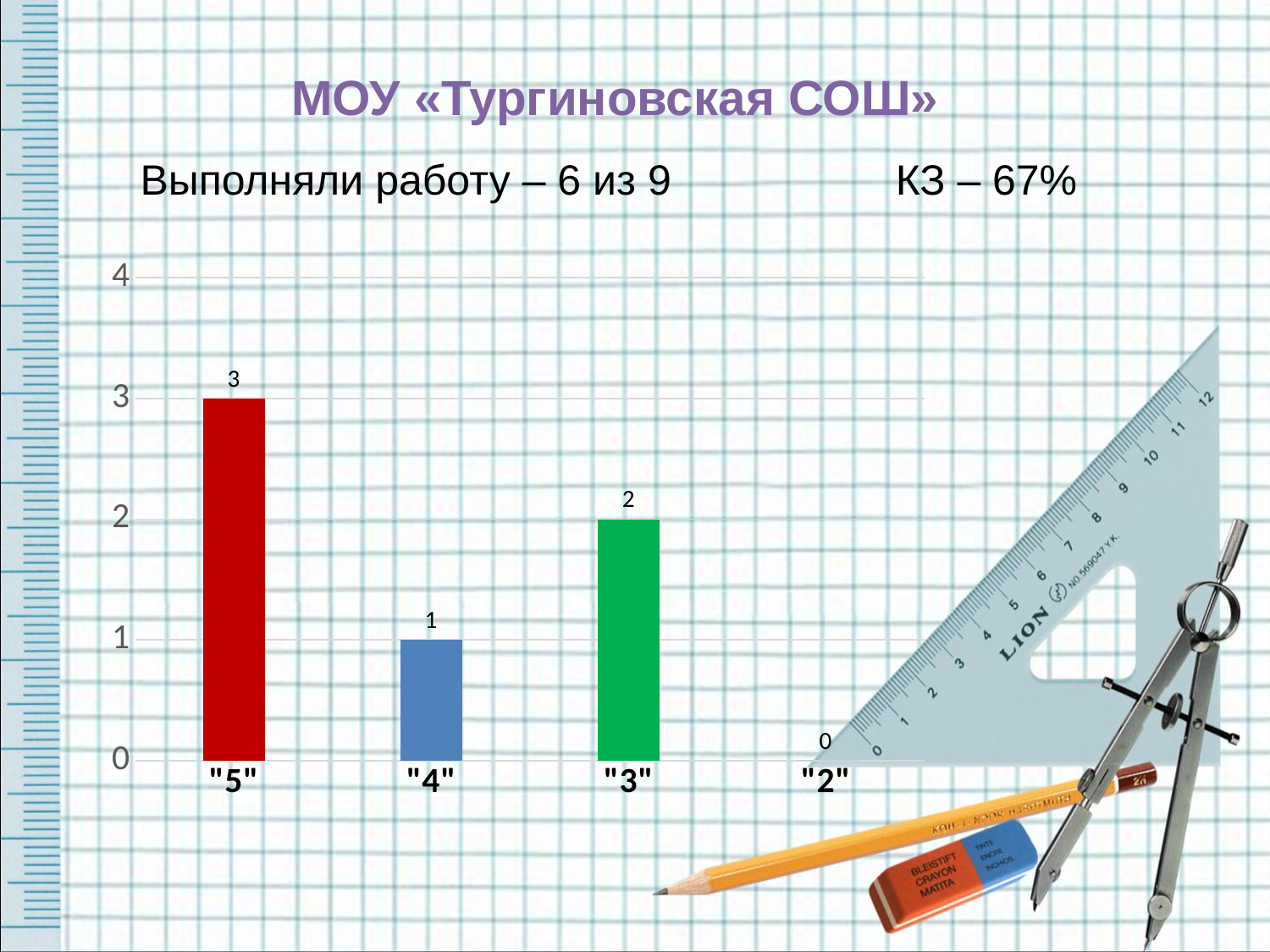
What is the value for the "4" category? 1 What is the difference between the values for "5" and "3"? 1 Which category has the highest value? "5" What is the total of the values for all four categories? 6 What is the value for the "5" category? 3 What is the value for the "3" category? 2 Which is larger, the value for "4" or the value for "3"? "3" What is the value for the "2" category? 0 What colour is the bar for the "5" category? red What kind of chart is shown on the slide? bar chart How many categories are shown on the x axis? 4 Which category has the lowest value? "2"